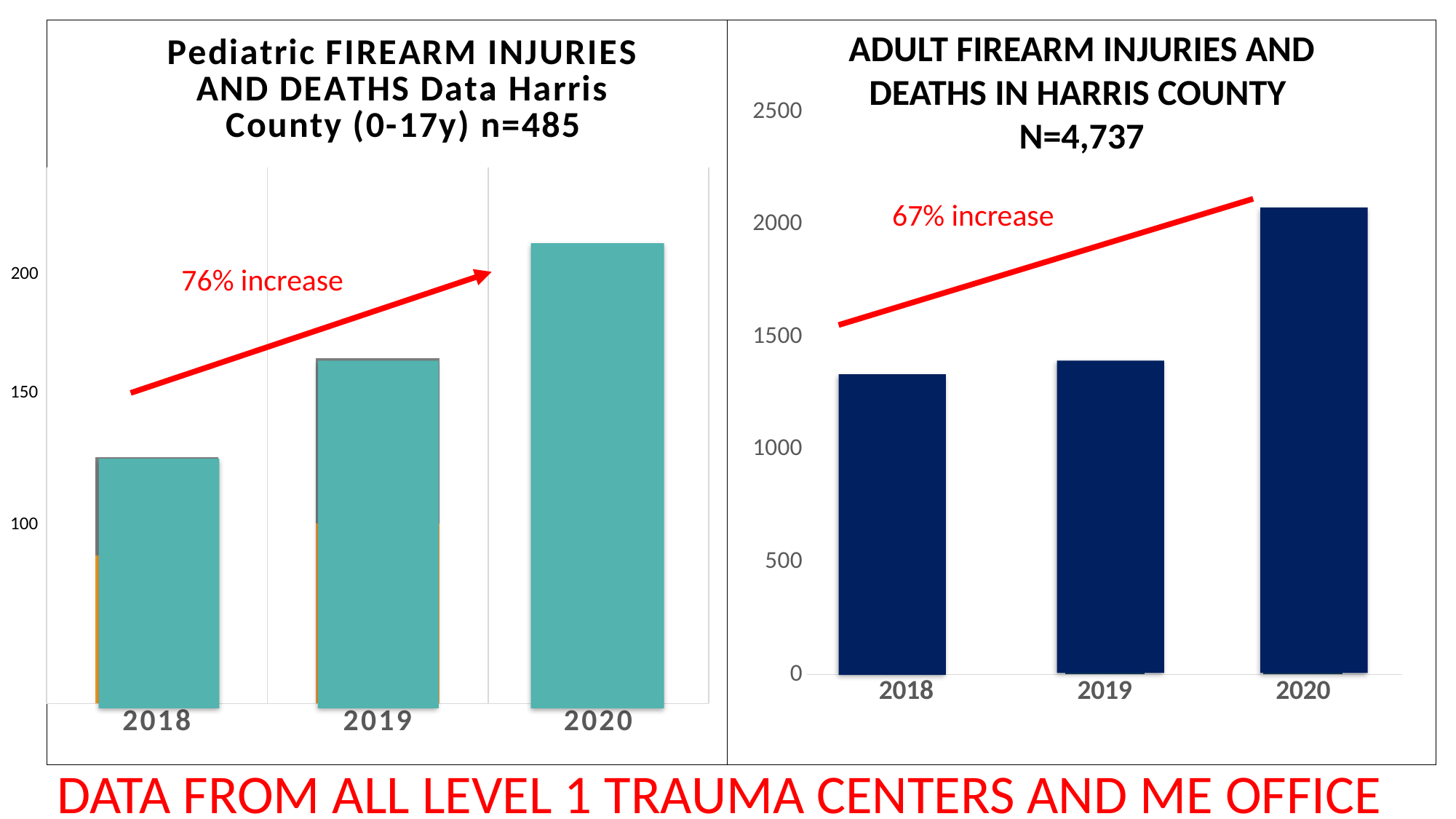
In the Pediatric chart on the left, which year has the lowest value? 2018 In the Pediatric chart on the left, do the values rise or fall from 2018 to 2020? rise In the Pediatric chart on the left, which year has the highest value? 2020 In the Adult chart on the right, is the value for 2020 greater or less than 2000? greater In the Pediatric chart on the left, how many years are shown on the x axis? 3 What percentage increase is annotated on the Adult chart on the right? 67% increase In the Adult chart on the right, which is larger, the value for 2019 or the value for 2020? 2020 In the Adult chart on the right, which year has the highest value? 2020 In the Pediatric chart on the left, is the value for 2018 greater or less than 150? less In the Adult chart on the right, is the value for 2018 greater or less than 1500? less What kind of chart is the Adult chart on the right? bar chart